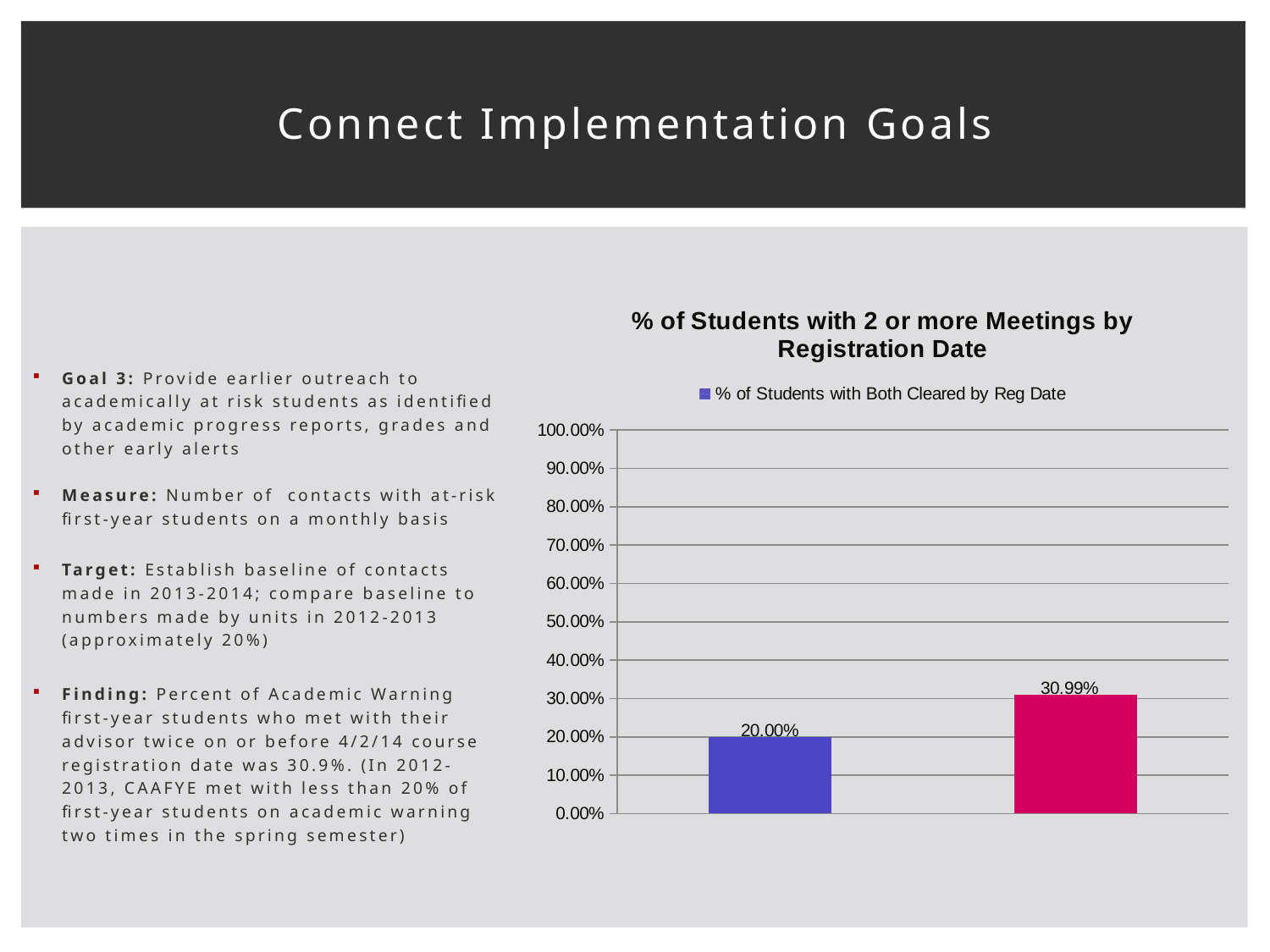
How many series does the legend list? 1 What is the difference between the right bar's value and the left bar's value? 10.99% What is the legend entry shown above the chart? % of Students with Both Cleared by Reg Date What kind of chart is shown on the slide? bar chart Is the value of the right pink bar greater or less than 40.00%? less Which bar has the lower value, the left blue bar or the right pink bar? the left blue bar Is the value of the left blue bar larger or smaller than the value of the right pink bar? smaller Which bar has the higher value, the left blue bar or the right pink bar? the right pink bar How many bars are plotted in the chart? 2 What is the value of the right (pink) bar in the chart? 30.99% What is the title of the chart? % of Students with 2 or more Meetings by Registration Date What is the value of the left (blue) bar in the chart? 20.00%